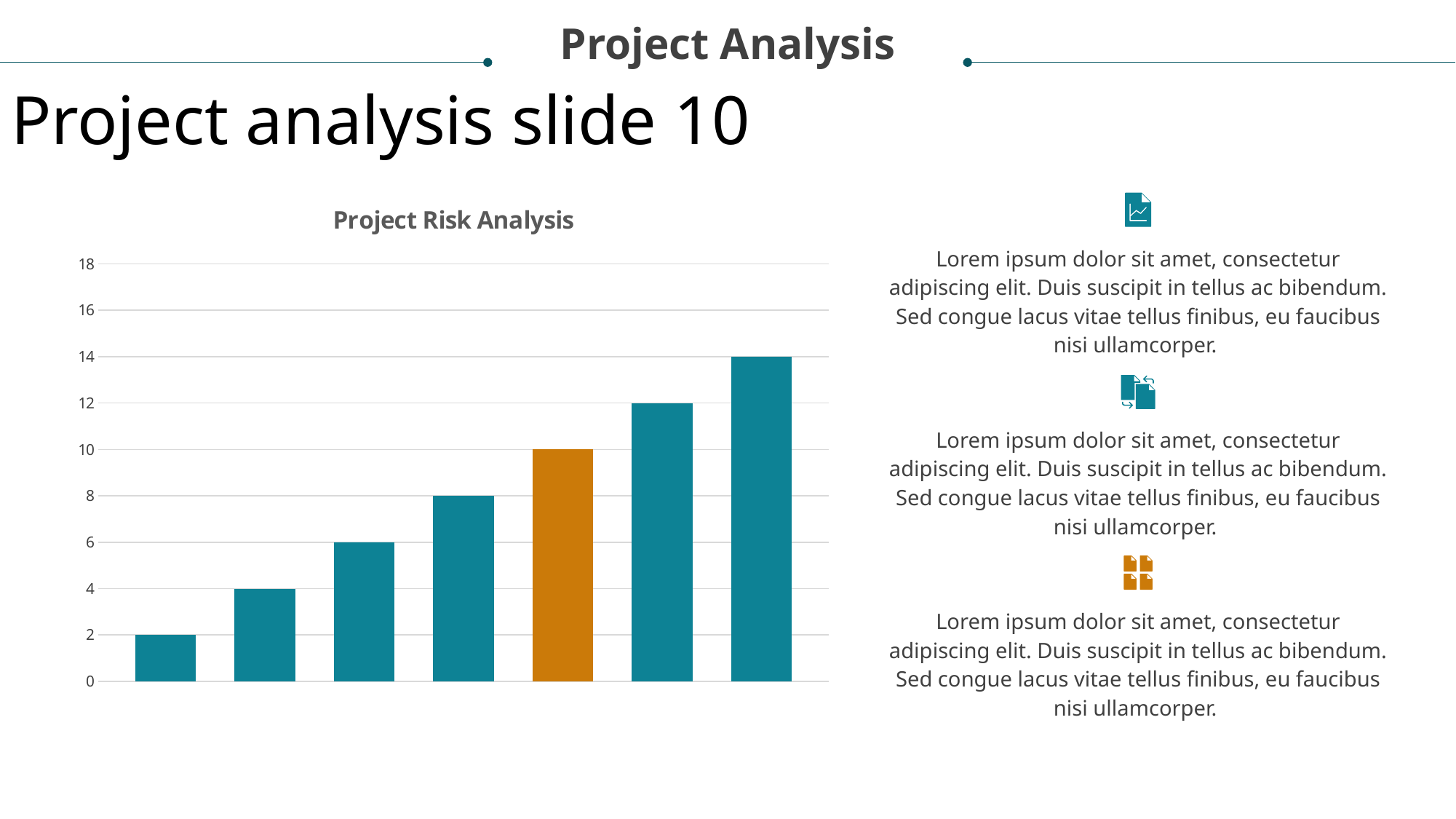
Which bar is the shortest in the Project Risk Analysis chart? the leftmost bar What is the value of the rightmost bar in the Project Risk Analysis chart? 14 Is the value of the sixth bar from the left in the Project Risk Analysis chart greater or less than 10? greater What is the value of the leftmost bar in the Project Risk Analysis chart? 2 Do the bar values rise or fall from left to right in the Project Risk Analysis chart? rise What is the difference between the rightmost bar and the orange bar in the Project Risk Analysis chart? 4 What is the value of the third bar from the left in the Project Risk Analysis chart? 6 Which bar is the tallest in the Project Risk Analysis chart? the rightmost bar What is the value of the orange bar in the Project Risk Analysis chart? 10 How many bars are plotted in the Project Risk Analysis chart? 7 What kind of chart is shown under the title "Project Risk Analysis"? bar chart What is the title of the chart? Project Risk Analysis